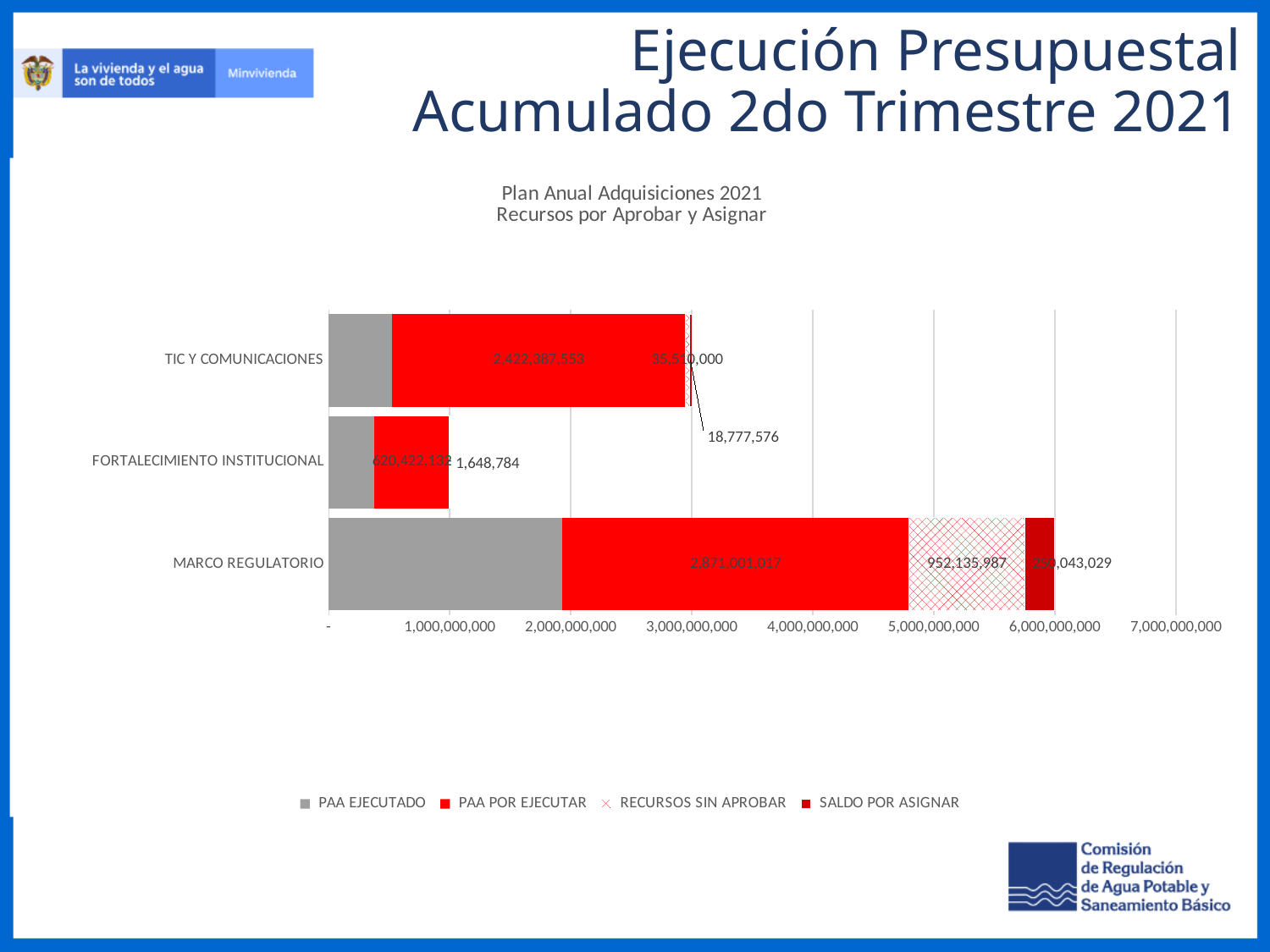
How many series does the legend list? 4 What kind of chart is shown on the slide? Stacked horizontal bar chart Which has the larger PAA POR EJECUTAR value, MARCO REGULATORIO or TIC Y COMUNICACIONES? MARCO REGULATORIO What is the title of the chart? Plan Anual Adquisiciones 2021 Recursos por Aprobar y Asignar What is the RECURSOS SIN APROBAR value for MARCO REGULATORIO? 952,135,987 What is the difference between the PAA POR EJECUTAR values for MARCO REGULATORIO and TIC Y COMUNICACIONES? 448,613,464 What is the PAA POR EJECUTAR value for TIC Y COMUNICACIONES? 2,422,387,553 What is the PAA POR EJECUTAR value for MARCO REGULATORIO? 2,871,001,017 Which category has the longest total stacked bar? MARCO REGULATORIO How many categories are plotted on the chart? 3 What is the SALDO POR ASIGNAR value for TIC Y COMUNICACIONES? 18,777,576 Is the total stacked bar for MARCO REGULATORIO greater or less than 5,000,000,000? greater